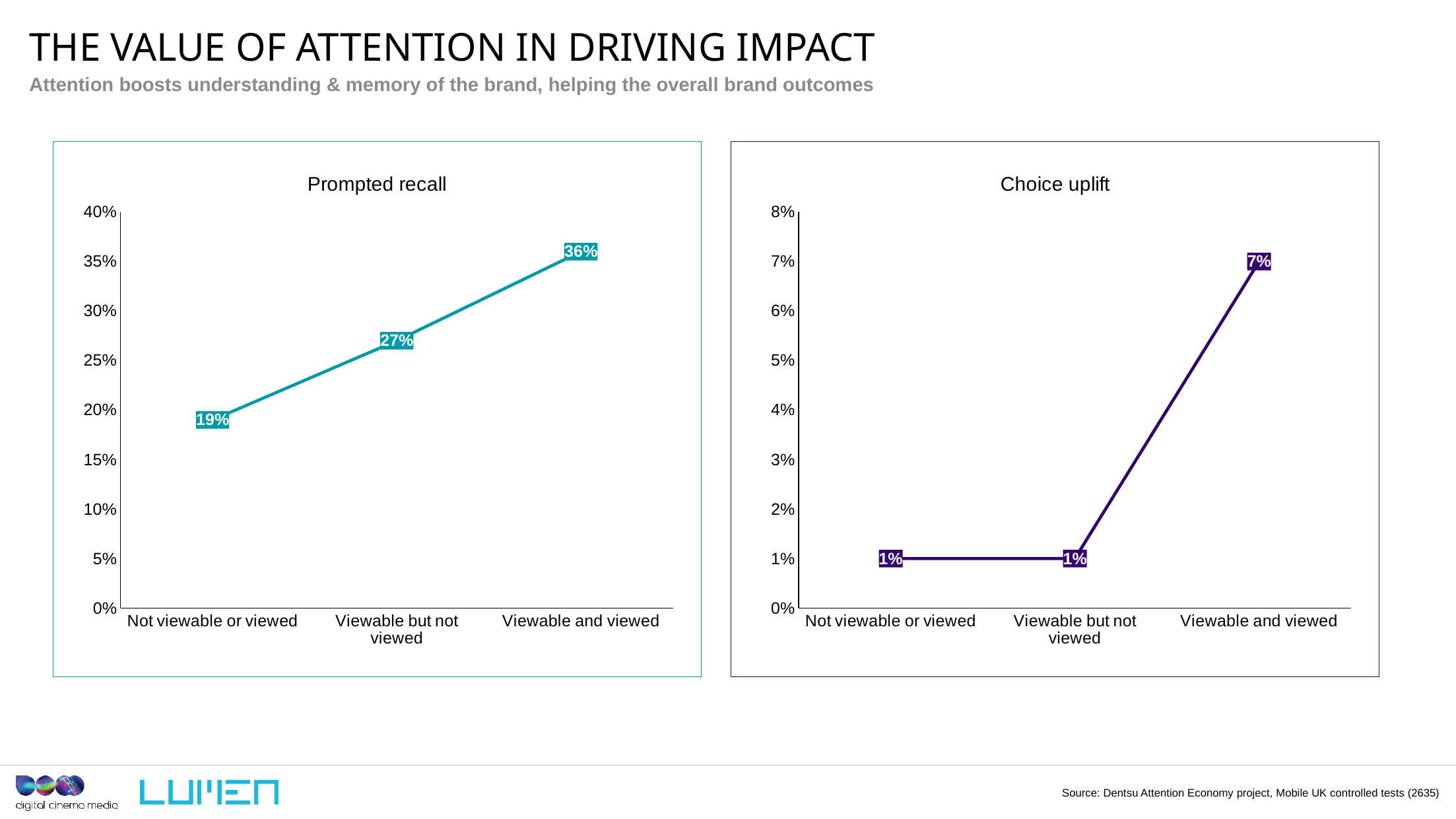
What kind of chart is the Prompted recall chart? Line chart In the Prompted recall chart, what is the value for Not viewable or viewed? 19% In the Choice uplift chart, what is the value for Viewable but not viewed? 1% How many categories are shown on the x axis of the Choice uplift chart? 3 In the Choice uplift chart, what is the difference between Viewable and viewed and Viewable but not viewed? 6% In the Prompted recall chart, what is the value for Viewable and viewed? 36% In the Prompted recall chart, which category has the lowest value? Not viewable or viewed In the Prompted recall chart, which category has the highest value? Viewable and viewed In the Choice uplift chart, what is the value for Viewable and viewed? 7% In the Prompted recall chart, which is larger: Viewable but not viewed or Not viewable or viewed? Viewable but not viewed In the Prompted recall chart, what is the difference between Viewable and viewed and Not viewable or viewed? 17% In the Choice uplift chart, which category has the highest value? Viewable and viewed